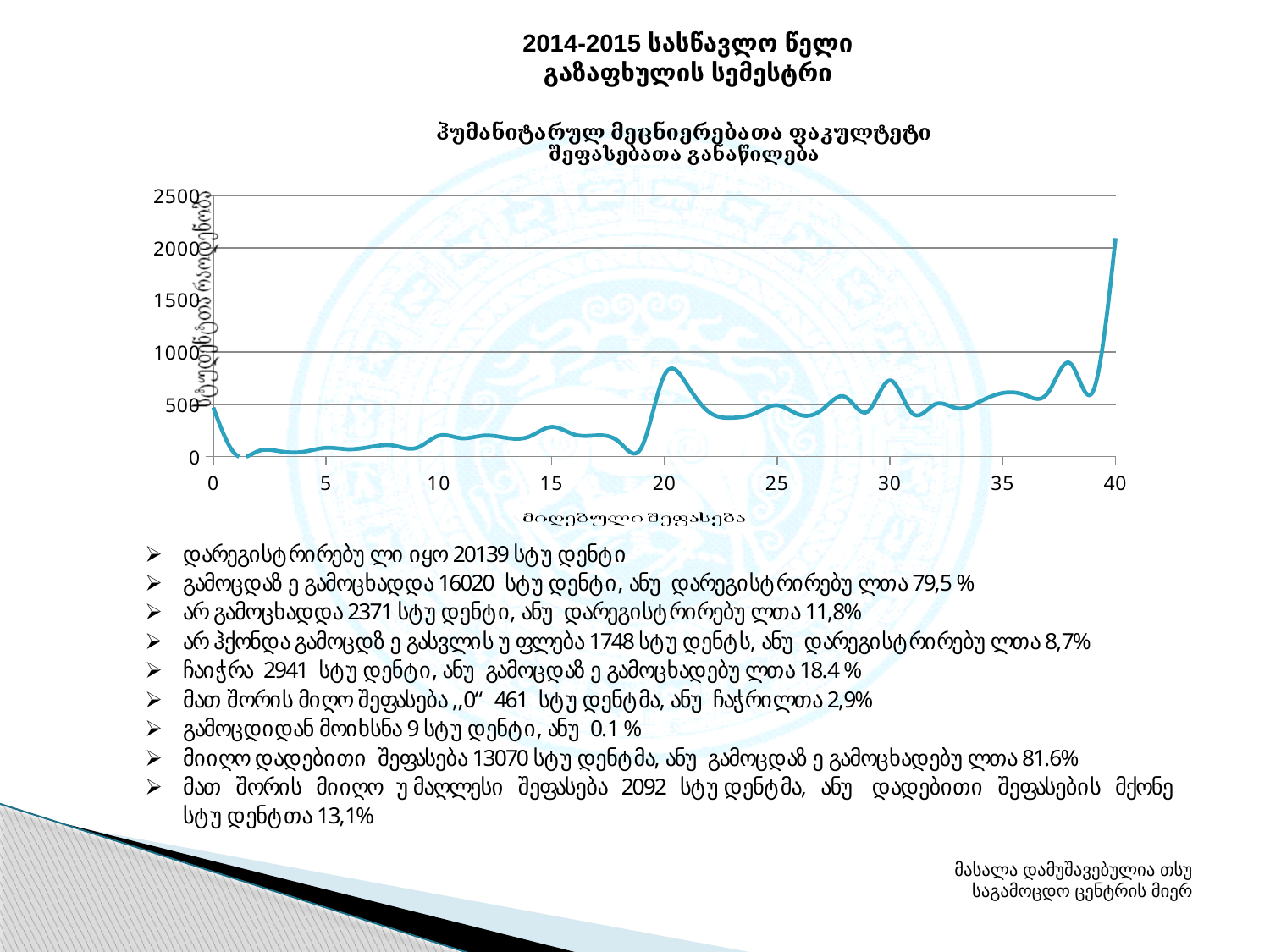
Which is larger, the value of the line at x = 20 or at x = 15? x = 20 Is the value of the line at x = 40 greater or less than 1500? greater What kind of chart is shown on the slide? line chart Does the line rise or fall between x = 39 and x = 40? rise What is the highest value shown on the y-axis? 2500 Is the value of the line at x = 20 greater or less than 1000? less Is the value of the line at x = 38 greater or less than 1000? less What is the highest value shown on the x-axis? 40 At which x-axis value does the line reach its highest point? 40